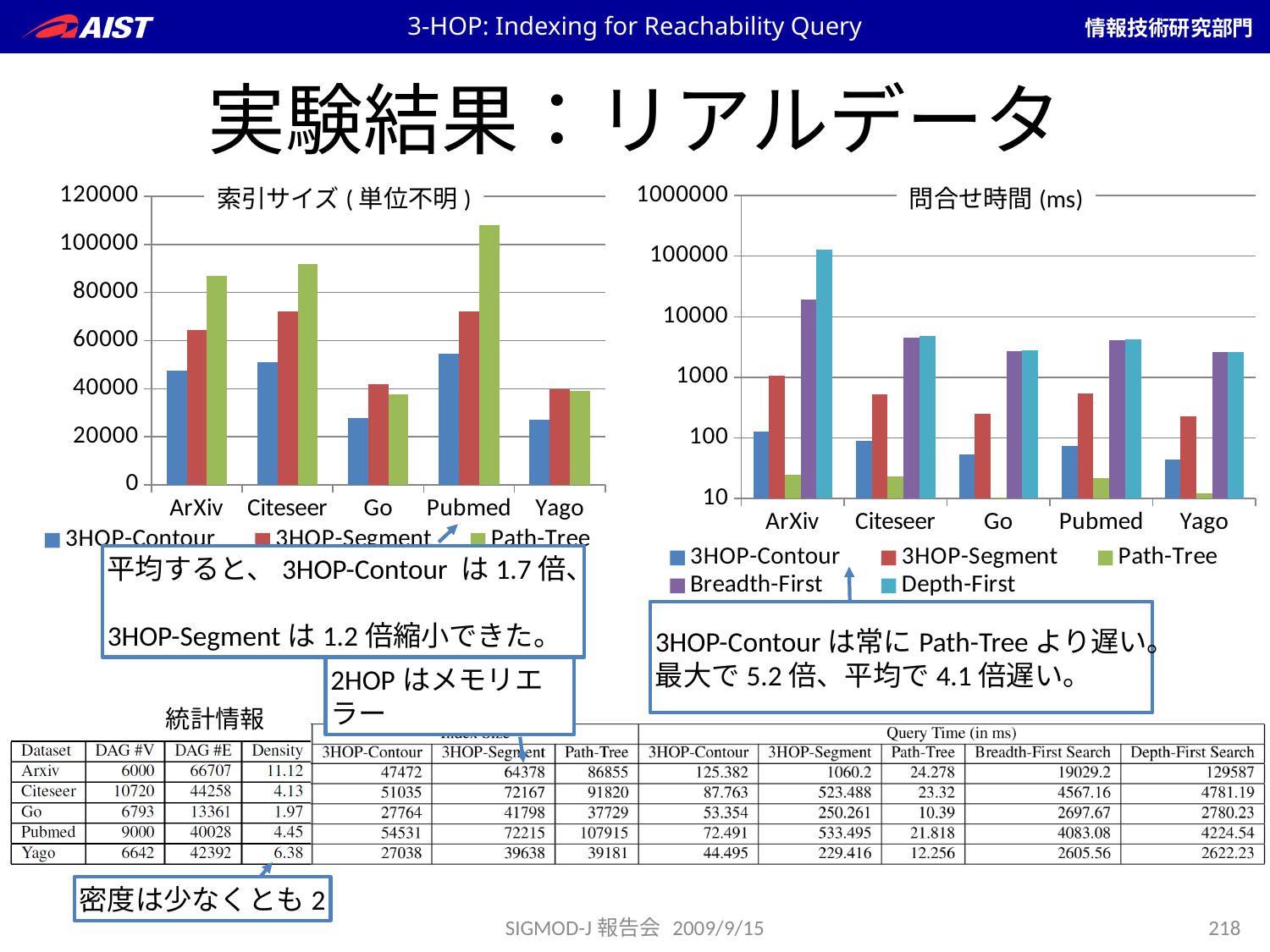
What kind of chart is the left chart titled 索引サイズ (単位不明)? bar chart How many series does the legend of the left chart (索引サイズ) list? 3 In the left chart (索引サイズ), is the Path-Tree value for Go greater or less than 40000? less In the right chart (問合せ時間 (ms)), is the 3HOP-Contour value for ArXiv greater or less than 100? greater In the right chart (問合せ時間 (ms)), which is larger for ArXiv: Breadth-First or Depth-First? Depth-First In the left chart (索引サイズ), which is larger for Citeseer: 3HOP-Contour or Path-Tree? Path-Tree How many datasets are shown on the x axis of the left chart (索引サイズ)? 5 What is the title of the right chart? 問合せ時間 (ms) In the left chart (索引サイズ), is the 3HOP-Contour value for ArXiv greater or less than 40000? greater How many series does the legend of the right chart (問合せ時間 (ms)) list? 5 In the right chart (問合せ時間 (ms)), which dataset has the tallest Depth-First bar? ArXiv In the left chart (索引サイズ), which dataset has the tallest Path-Tree bar? Pubmed